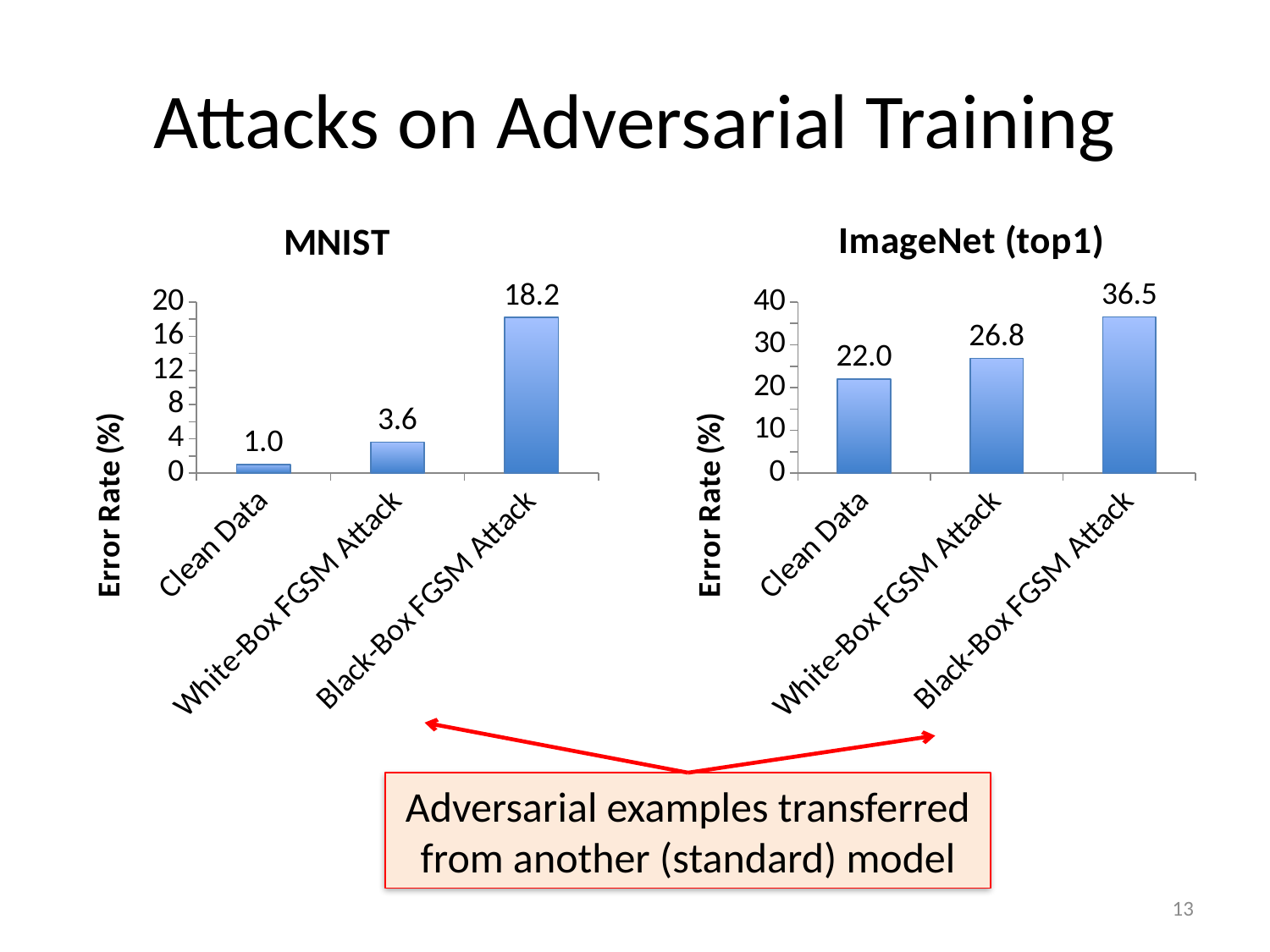
In the ImageNet (top1) chart, what is the error rate for the Black-Box FGSM Attack? 36.5 In the ImageNet (top1) chart, what is the error rate for the White-Box FGSM Attack? 26.8 In the MNIST chart, what is the error rate for Clean Data? 1.0 In the ImageNet (top1) chart, which category has the lowest error rate? Clean Data In the ImageNet (top1) chart, which is larger, the error rate for Clean Data or for the White-Box FGSM Attack? White-Box FGSM Attack How many categories are shown in the MNIST chart? 3 In the MNIST chart, which category has the highest error rate? Black-Box FGSM Attack What is the y-axis label of the MNIST chart? Error Rate (%) In the ImageNet (top1) chart, what is the difference between the Black-Box FGSM Attack and Clean Data error rates? 14.5 In the MNIST chart, what is the error rate for the White-Box FGSM Attack? 3.6 What kind of chart is the ImageNet (top1) chart? Bar chart In the MNIST chart, what is the difference between the Black-Box FGSM Attack and White-Box FGSM Attack error rates? 14.6